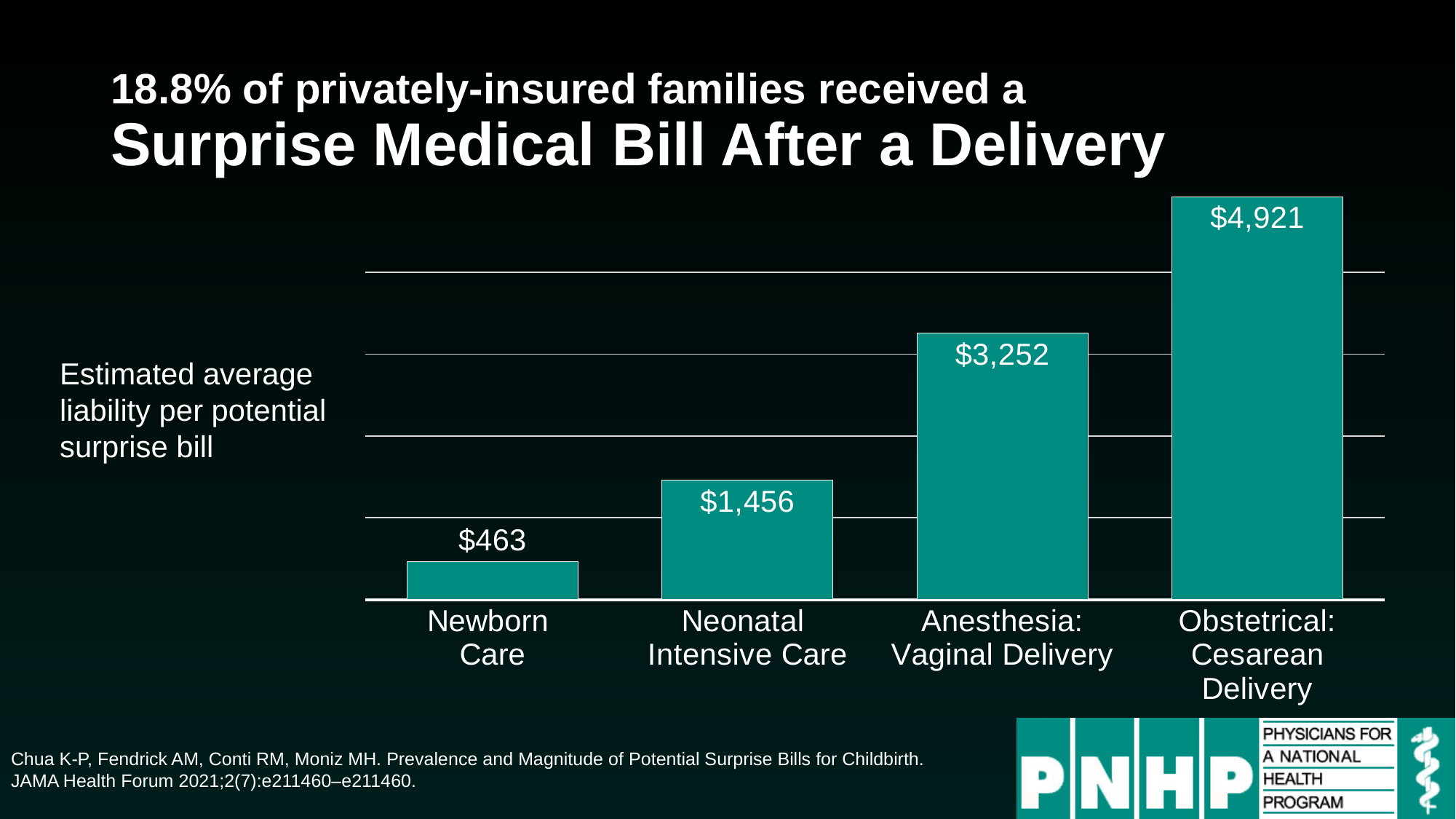
Which is larger, the estimated average liability for Anesthesia: Vaginal Delivery or for Neonatal Intensive Care? Anesthesia: Vaginal Delivery What kind of chart is shown on the slide? Bar chart What is the estimated average liability per potential surprise bill for Obstetrical: Cesarean Delivery? $4,921 What is the difference between the estimated average liability for Obstetrical: Cesarean Delivery and Anesthesia: Vaginal Delivery? $1,669 What is the estimated average liability per potential surprise bill for Anesthesia: Vaginal Delivery? $3,252 Which category has the lowest estimated average liability? Newborn Care How many categories are shown in the chart? 4 Do the values rise or fall from left to right across the categories? Rise What is the estimated average liability per potential surprise bill for Neonatal Intensive Care? $1,456 What is the estimated average liability per potential surprise bill for Newborn Care? $463 Which category has the highest estimated average liability? Obstetrical: Cesarean Delivery What is the difference between the estimated average liability for Neonatal Intensive Care and Newborn Care? $993